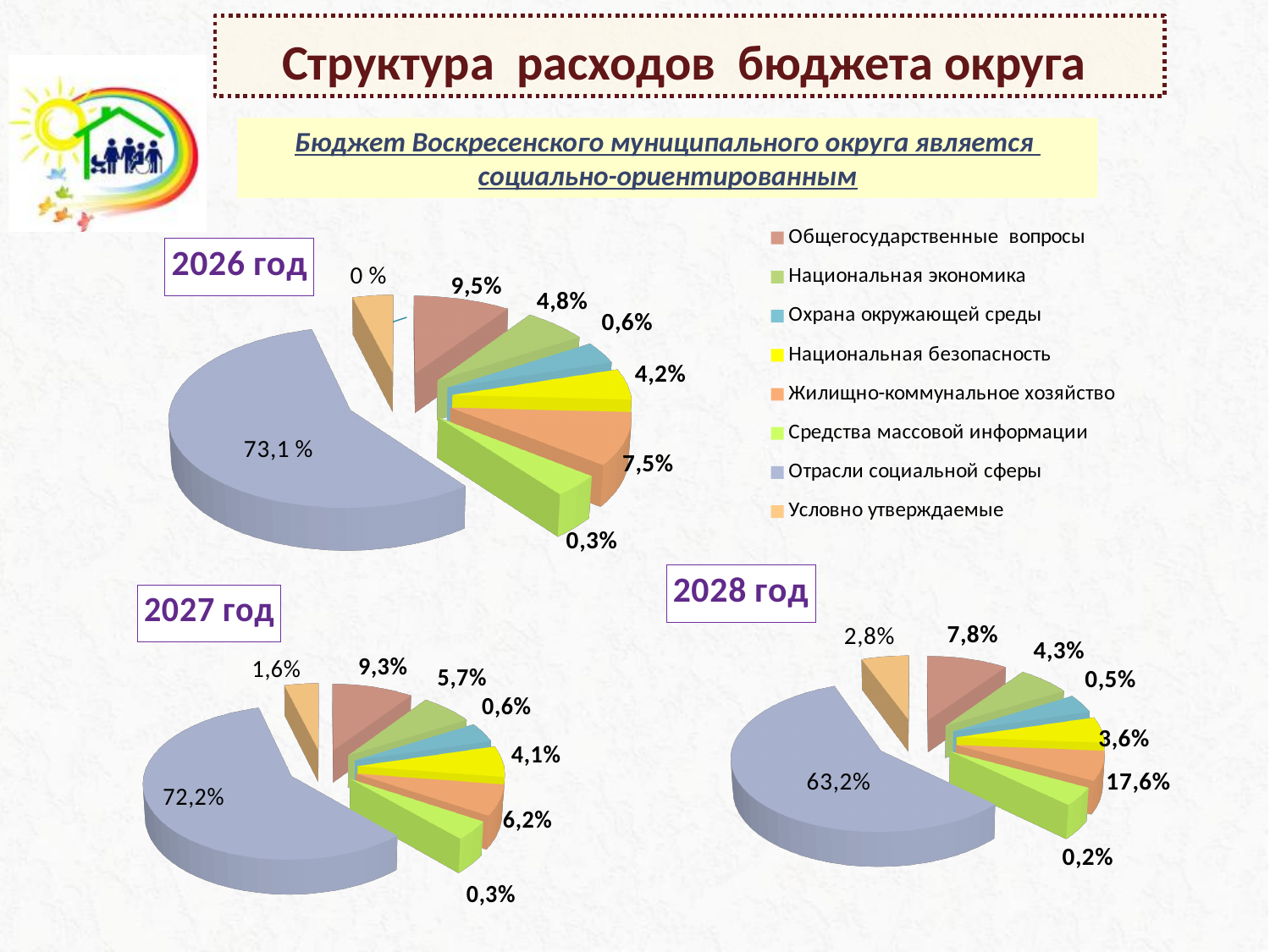
In the 2027 год chart, which category has the largest share? Отрасли социальной сферы Which legend entry is shown in yellow? Национальная безопасность What is the difference between the share of Отрасли социальной сферы in the 2026 год chart and in the 2028 год chart? 9,9 percentage points In the 2028 год chart, what share is shown for Жилищно-коммунальное хозяйство? 17,6% In the 2028 год chart, what share is shown for Условно утверждаемые? 2,8% In the 2028 год chart, which category has the smallest share? Средства массовой информации How many categories does the legend list for the pie charts? 8 In the 2026 год chart, what share is shown for Отрасли социальной сферы? 73,1 % In the 2027 год chart, what share is shown for Общегосударственные вопросы? 9,3% How many pie charts are shown on the slide? 3 What type of chart is used for the 2026 год data? Pie chart In the 2027 год chart, which is larger: the share of Национальная экономика or the share of Жилищно-коммунальное хозяйство? Жилищно-коммунальное хозяйство